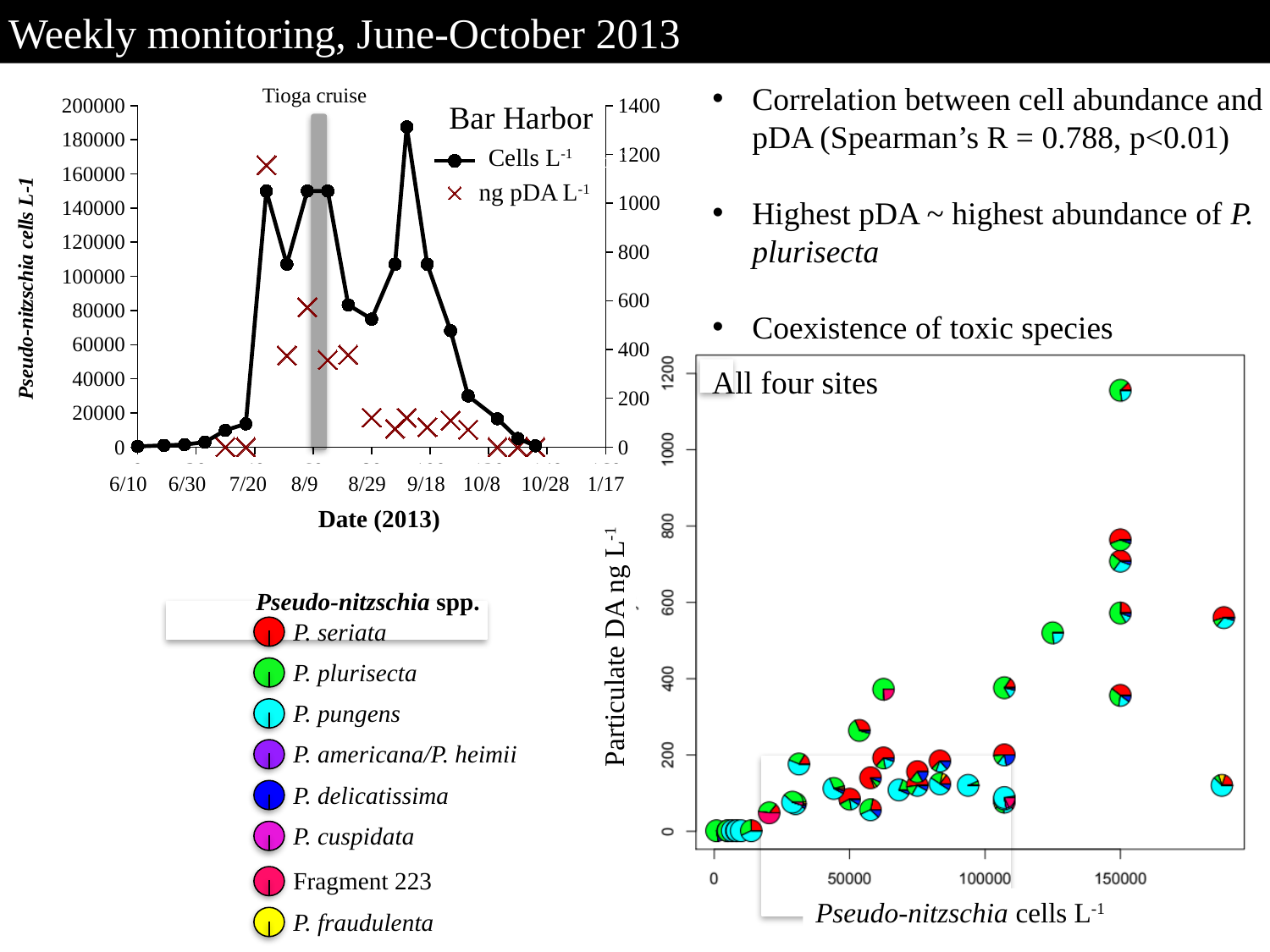
How many series does the legend of the Bar Harbor chart list? 2 In the Bar Harbor chart, is the Cells L-1 value on 8/9 greater or less than 140000? greater How many Pseudo-nitzschia spp. entries are listed in the species legend? 8 What kind of chart is the Bar Harbor chart? line chart In the All four sites scatter plot, is the highest Particulate DA value greater or less than 1000? greater In the Bar Harbor chart, is the highest ng pDA L-1 value greater or less than 1000? greater What event does the grey vertical band in the Bar Harbor chart mark? Tioga cruise In the All four sites scatter plot, does Particulate DA generally rise or fall as Pseudo-nitzschia cells increase? rise In the Bar Harbor chart, do Cells L-1 values rise or fall between 9/18 and 10/28? fall In the Bar Harbor chart, do Cells L-1 values rise or fall between 6/10 and 7/20? rise